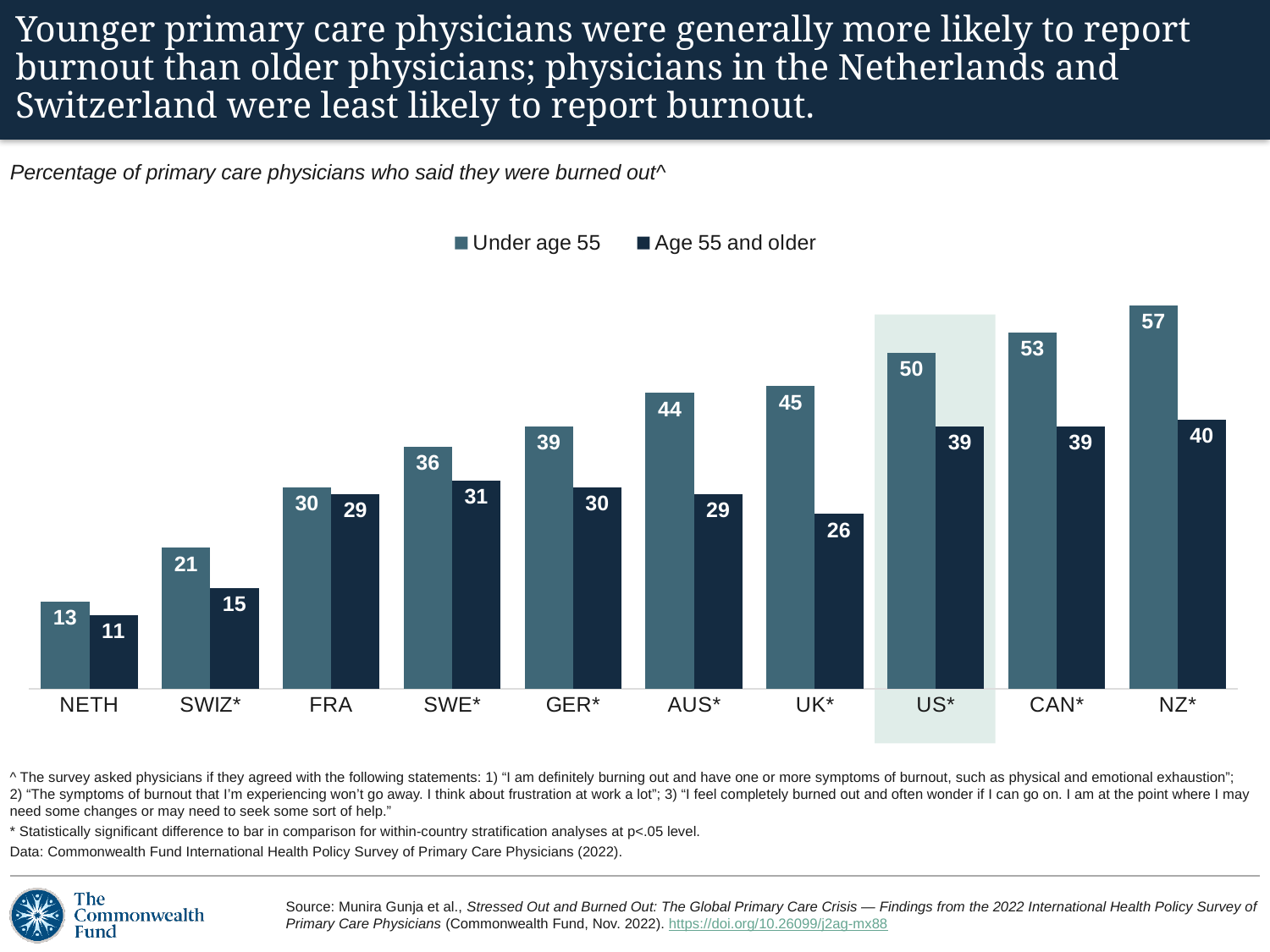
What is the value for Under age 55 in the US*? 50 Do the Under age 55 values rise or fall from NETH to NZ* along the x axis? Rise What kind of chart is shown on the slide? Bar chart Which country has the lowest value for Age 55 and older? NETH How many series does the legend list? 2 What is the value for Age 55 and older in SWE*? 31 What is the difference between the Under age 55 and Age 55 and older values for the UK*? 19 Which is larger: the Under age 55 value for CAN* or the Under age 55 value for AUS*? CAN* What is the value for Age 55 and older in the UK*? 26 How many countries are shown on the x axis? 10 Which country has the highest value for Under age 55? NZ* What are the two series listed in the legend? Under age 55; Age 55 and older